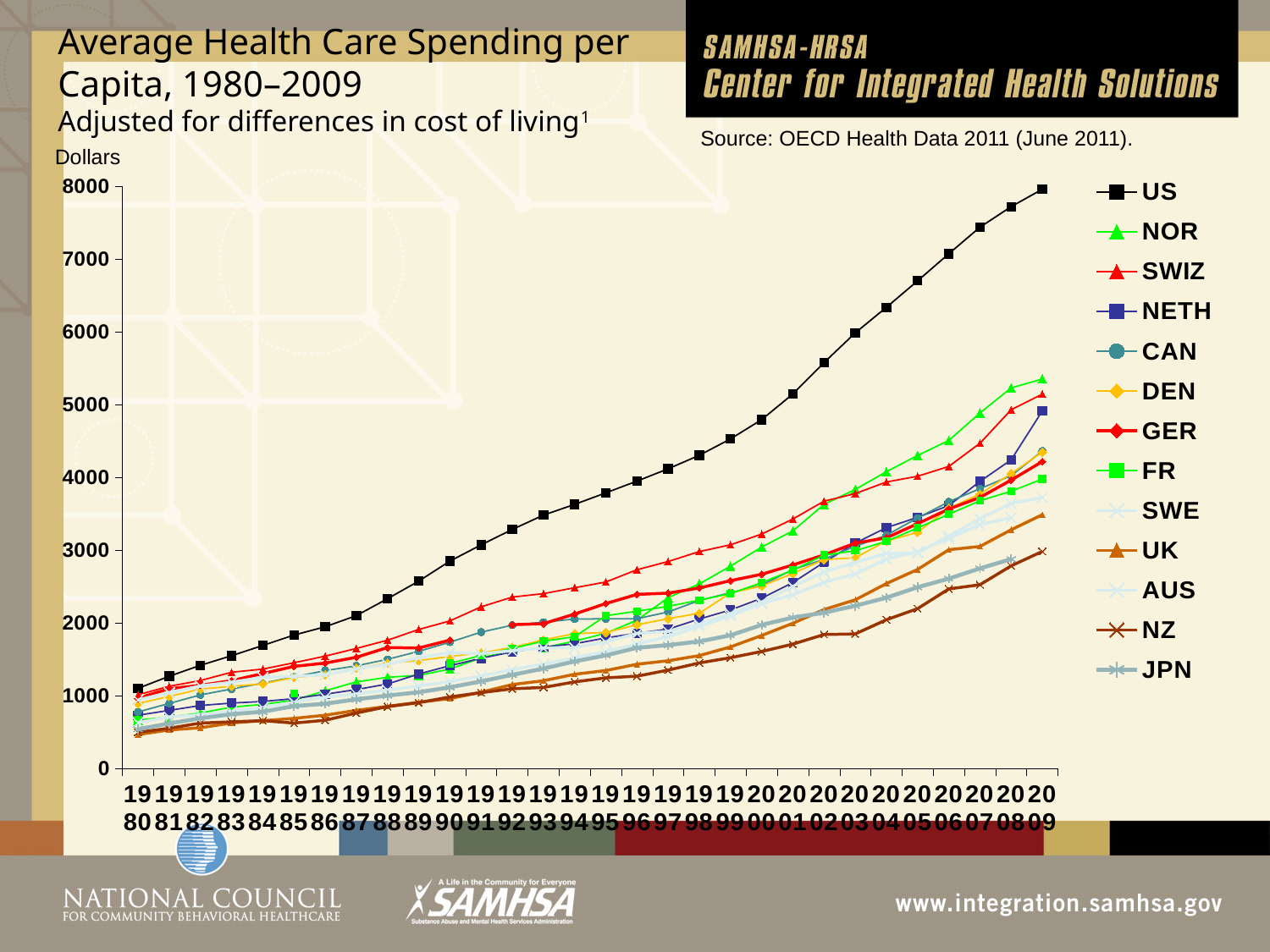
What unit is shown as the label of the y axis? Dollars How many series does the legend list? 13 Is the value for NOR in 2009 greater or less than 5000? greater Is the value for the US in 1990 greater or less than 3000? less Is the value for the UK in 2009 greater or less than 3000? greater What kind of chart is shown on the slide? line chart Does the US line rise or fall from 1980 to 2009? rise Which country has the highest health care spending per capita in 2009? US Which is larger in 2009, the value for GER or the value for the UK? GER How many years are plotted along the x axis? 30 What is the source cited for the chart data? OECD Health Data 2011 (June 2011)